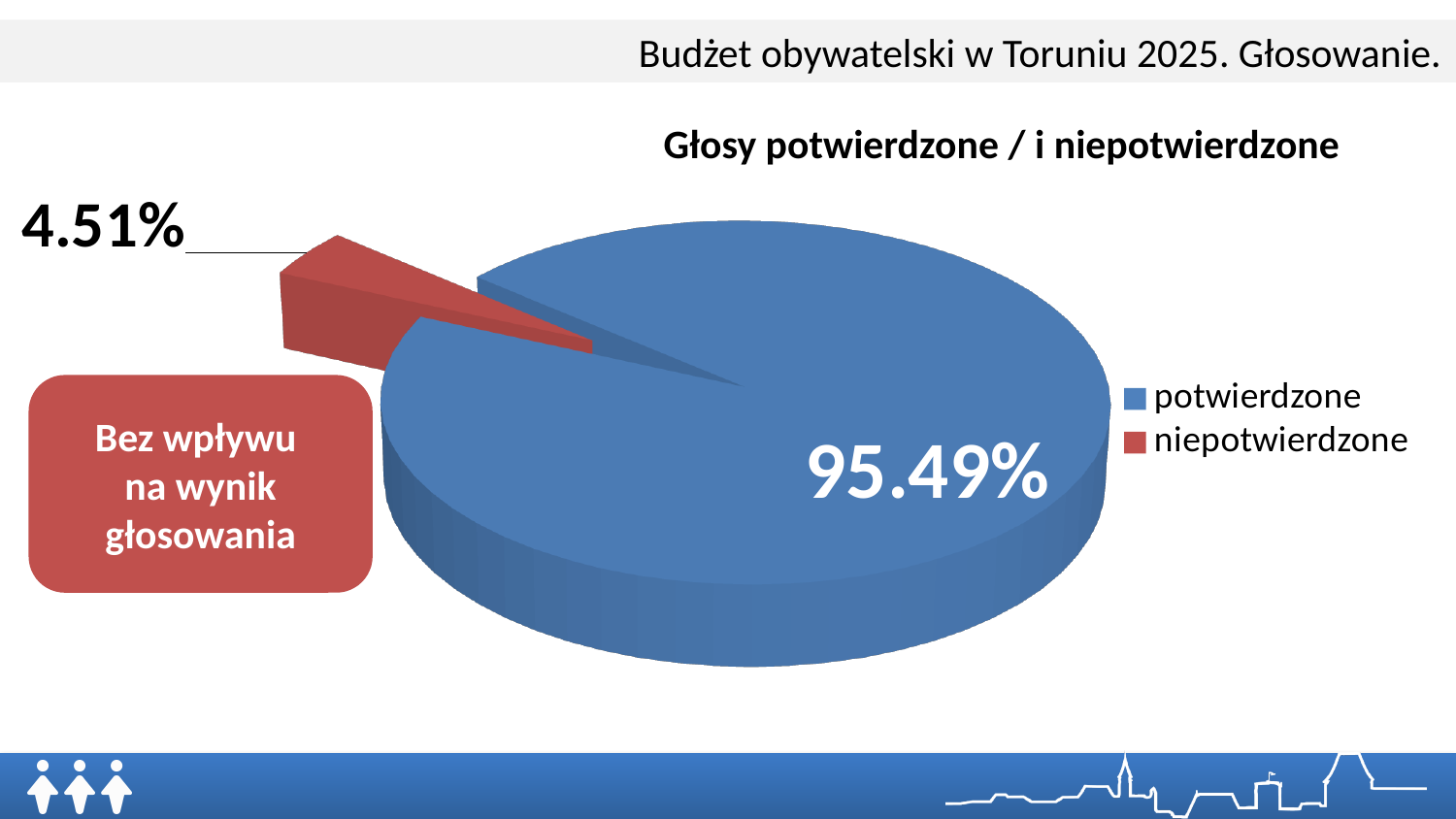
What is the title of the chart? Głosy potwierdzone / i niepotwierdzone Which category has the smallest slice of the pie? niepotwierdzone Which is larger, the 'potwierdzone' slice or the 'niepotwierdzone' slice? potwierdzone Which category has the largest slice of the pie? potwierdzone What is the difference in percentage points between the 'potwierdzone' and 'niepotwierdzone' slices? 90.98 How many entries does the legend list? 2 How many slices does the pie chart have? 2 What share of the pie does the 'potwierdzone' slice represent? 95.49% What share of the pie does the 'niepotwierdzone' slice represent? 4.51% What colour is the 'niepotwierdzone' slice? red What kind of chart is shown on the slide? pie chart